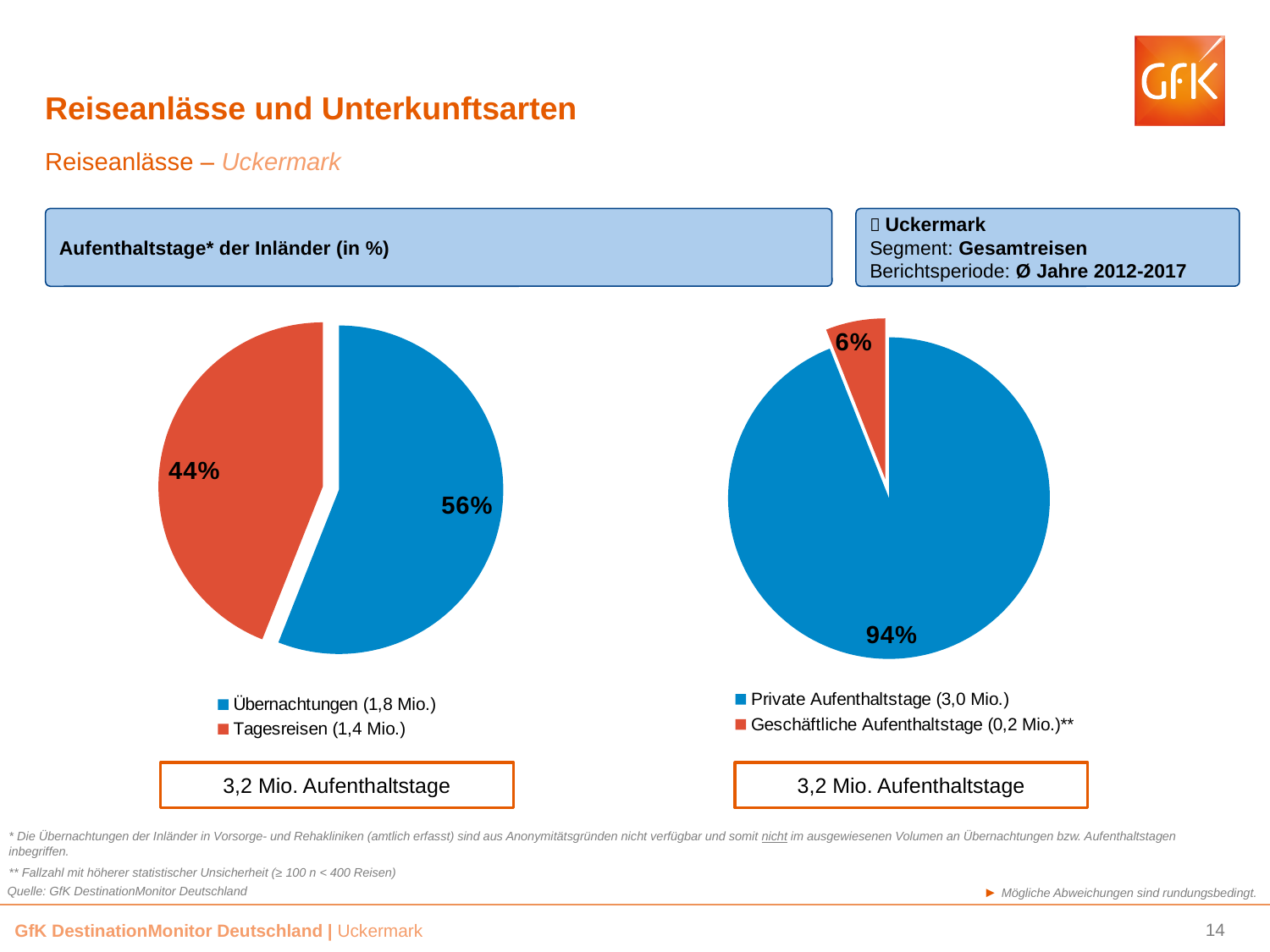
In the right pie chart, what share do Private Aufenthaltstage have? 94% In the left pie chart, what is the difference in percentage points between Übernachtungen and Tagesreisen? 12 percentage points How many entries does the legend of the left pie chart list? 2 In the right pie chart, what is the difference in percentage points between Private and Geschäftliche Aufenthaltstage? 88 percentage points In the right pie chart, which category has the smallest share? Geschäftliche Aufenthaltstage In the right pie chart, what share do Geschäftliche Aufenthaltstage have? 6% What type of chart is shown on the left side of the slide? Pie chart According to the legend of the right pie chart, how many Mio. Private Aufenthaltstage are there? 3,0 Mio. In the left pie chart, what share do Tagesreisen have? 44% How many slices does the right pie chart have? 2 In the left pie chart, what share do Übernachtungen have? 56% In the left pie chart, which slice is larger: Übernachtungen or Tagesreisen? Übernachtungen